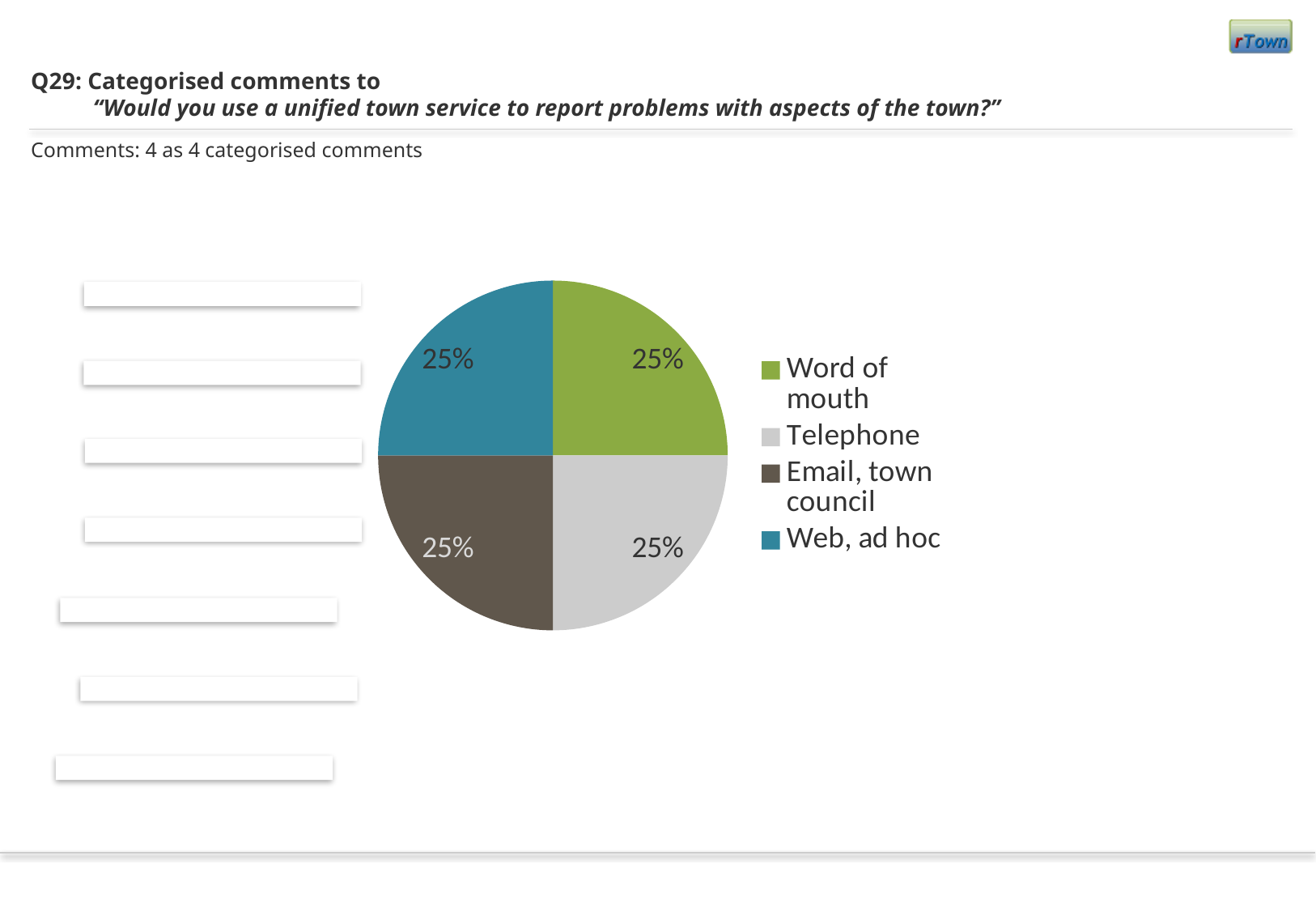
What is the value shown for the Web, ad hoc slice? 25% What is the difference between the Telephone and Web, ad hoc values? 0% What kind of chart is shown on the slide? pie chart How many slices does the pie chart have? 4 Which legend entry is shown in green? Word of mouth How many entries does the legend list? 4 What is the value shown for the Email, town council slice? 25% What is the value shown for the Word of mouth slice? 25% What share of the pie does the Telephone slice represent? 25% Which colour represents Web, ad hoc in the legend? teal blue